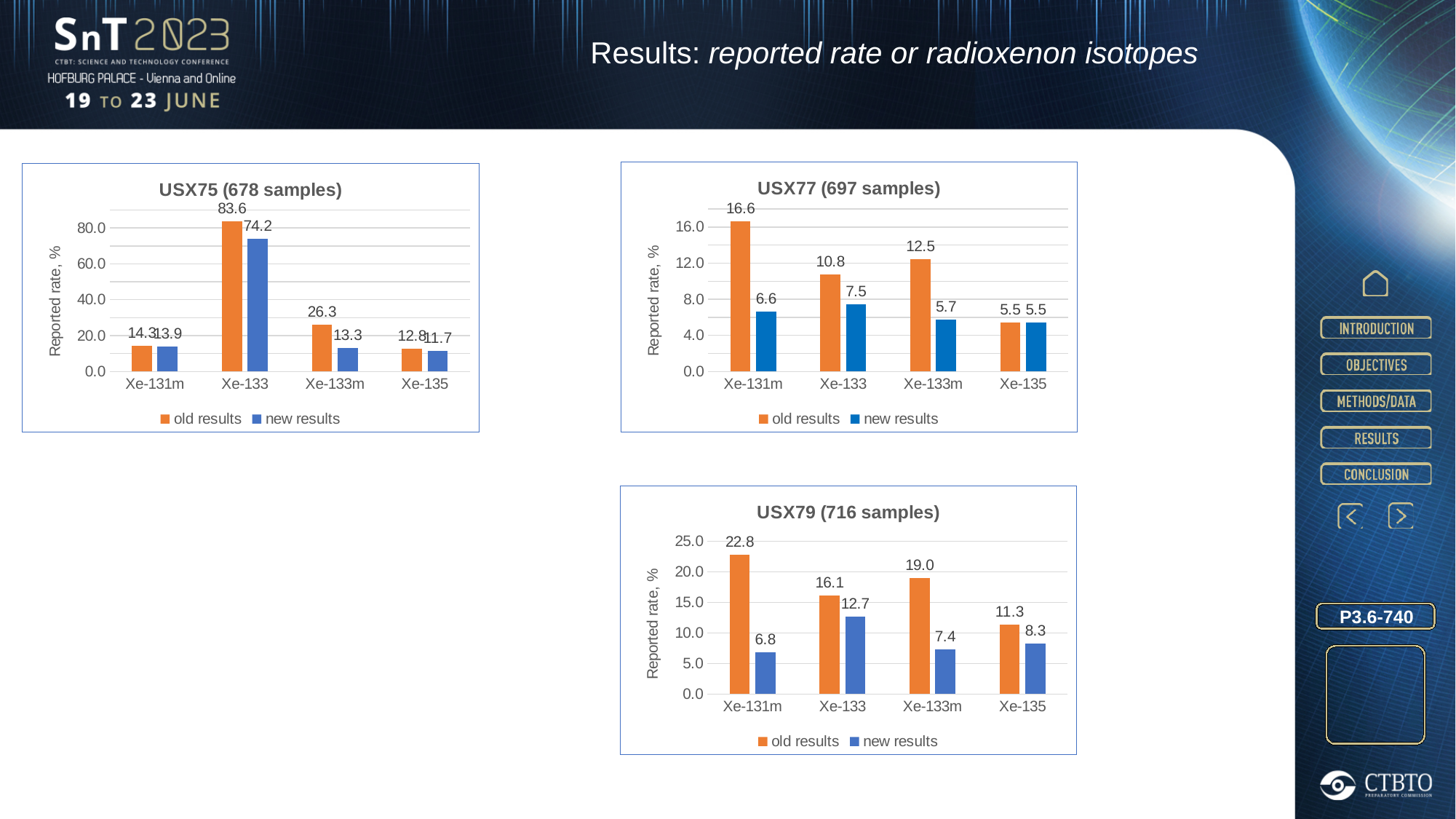
In the USX79 (716 samples) chart, what is the difference between the old and new results for Xe-131m? 16.0 How many series does the legend of the USX77 (697 samples) chart list? 2 What type of chart is the USX75 (678 samples) chart? bar chart In the USX77 (697 samples) chart, which is larger for Xe-133: the old results or the new results? old results In the USX75 (678 samples) chart, what is the old results value for Xe-133? 83.6 In the USX75 (678 samples) chart, what is the difference between the old and new results for Xe-133? 9.4 In the USX79 (716 samples) chart, what is the new results value for Xe-135? 8.3 How many isotope categories are shown in the USX79 (716 samples) chart? 4 In the USX75 (678 samples) chart, what is the new results value for Xe-133m? 13.3 In the USX77 (697 samples) chart, which isotope has the lowest old results value? Xe-135 In the USX77 (697 samples) chart, what is the old results value for Xe-131m? 16.6 In the USX79 (716 samples) chart, which isotope has the highest old results value? Xe-131m